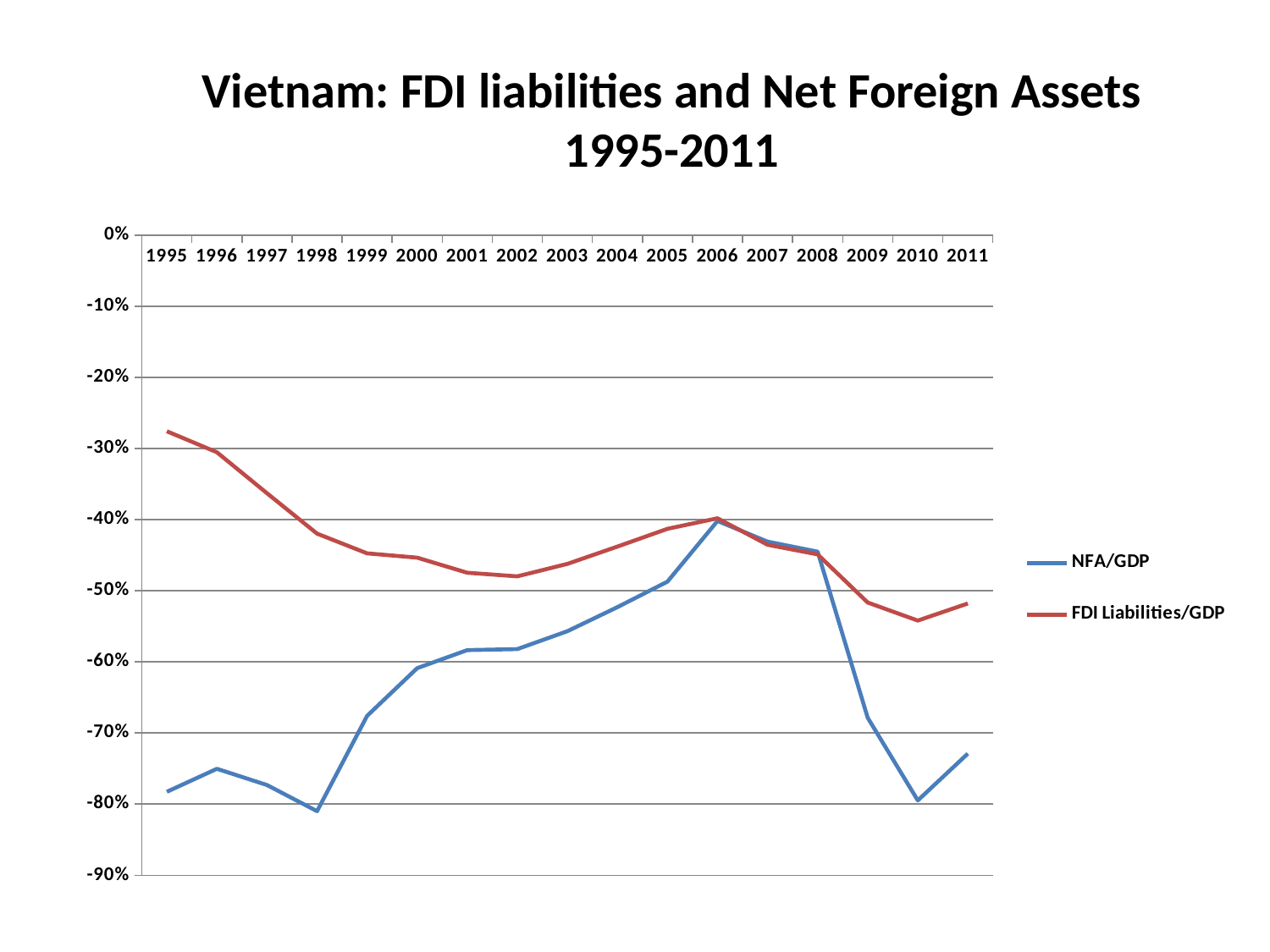
How many series does the legend list? 2 Is the value for NFA/GDP in 2000 greater or less than -60%? less Is the value for FDI Liabilities/GDP in 1995 greater or less than -30%? greater Which series is drawn in red? FDI Liabilities/GDP How many years are plotted along the x axis? 17 In 2000, which series has the higher value, NFA/GDP or FDI Liabilities/GDP? FDI Liabilities/GDP Is the value for NFA/GDP in 1998 greater or less than -80%? less In which year does the NFA/GDP series reach its highest value? 2006 What kind of chart is shown on the slide? line chart Does the NFA/GDP series rise or fall between 1998 and 2006? rise In which year does the FDI Liabilities/GDP series reach its highest value? 1995 What is the title of the chart? Vietnam: FDI liabilities and Net Foreign Assets 1995-2011